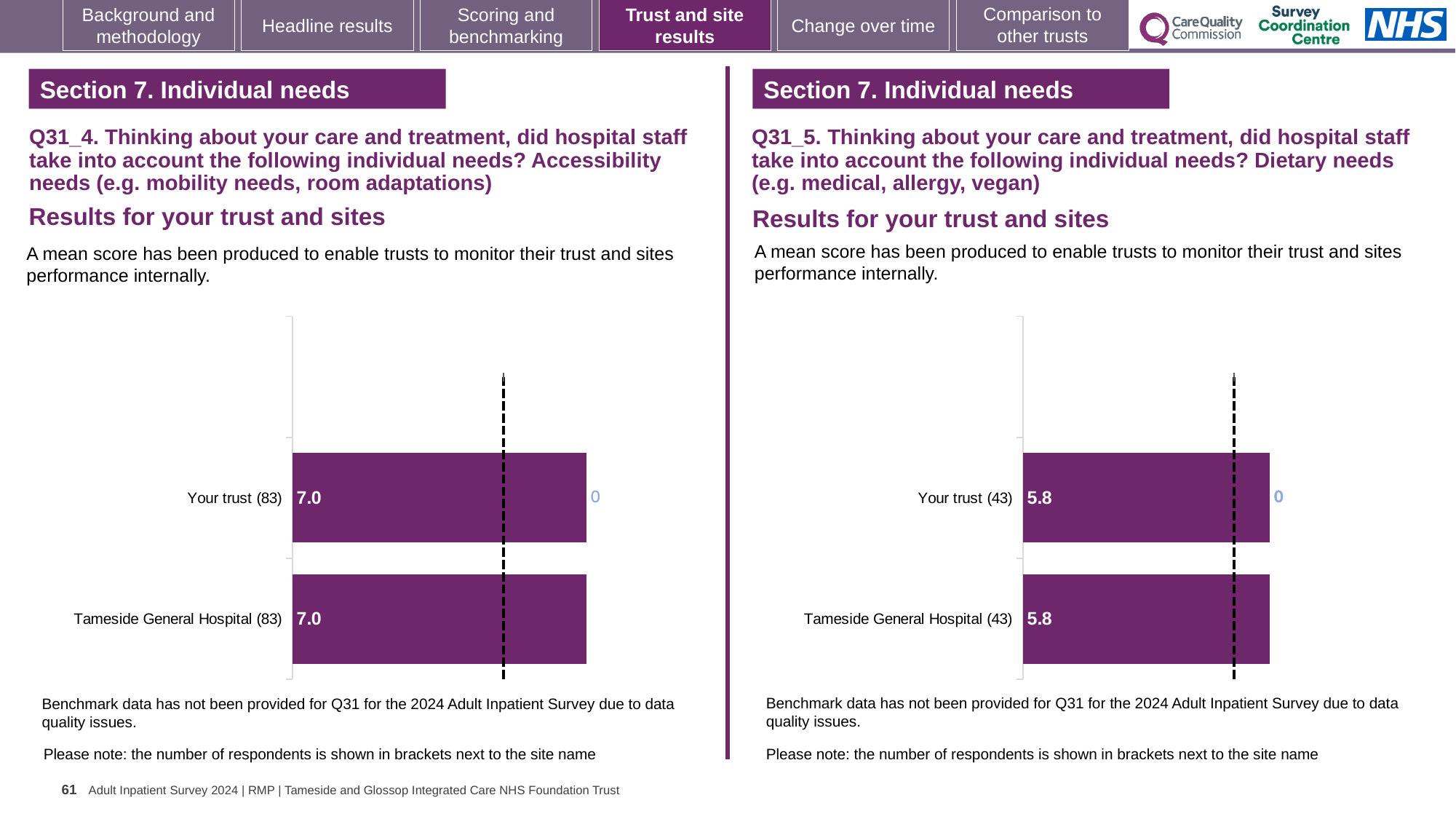
In the right chart (Q31_5), what is the difference between the score for Your trust and the score for Tameside General Hospital? 0.0 In the left chart (Q31_4), how many respondents are shown in brackets next to Your trust? 83 What kind of chart is used in the left chart (Q31_4)? Bar chart How many bars are plotted in the left chart (Q31_4)? 2 In the right chart (Q31_5, dietary needs), what is the mean score for Your trust? 5.8 How many bars are plotted in the right chart (Q31_5)? 2 In the right chart (Q31_5), how many respondents are shown in brackets next to Tameside General Hospital? 43 In the left chart (Q31_4, accessibility needs), what is the mean score for Your trust? 7.0 What kind of chart is used in the right chart (Q31_5)? Bar chart In the left chart (Q31_4, accessibility needs), what is the mean score for Tameside General Hospital? 7.0 In the right chart (Q31_5, dietary needs), what is the mean score for Tameside General Hospital? 5.8 In the left chart (Q31_4), what is the difference between the score for Your trust and the score for Tameside General Hospital? 0.0